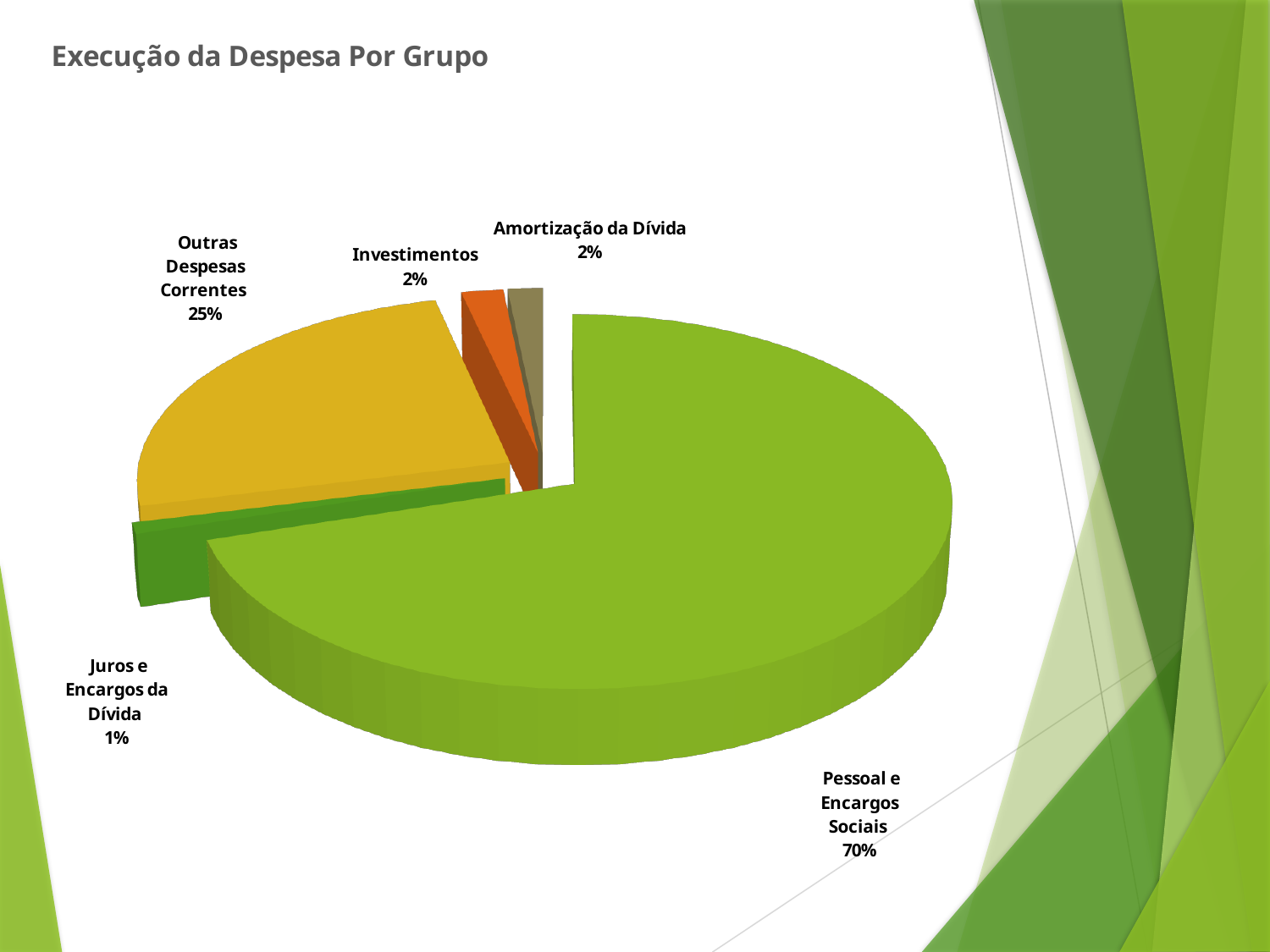
Which category has the largest slice of the pie? Pessoal e Encargos Sociais What is the value shown for Juros e Encargos da Dívida? 1% What is the title of the slide? Execução da Despesa Por Grupo What is the difference in percentage points between Pessoal e Encargos Sociais and Outras Despesas Correntes? 45 How many categories are shown in the pie chart? 5 What is the value shown for Investimentos? 2% Which category has the smallest slice of the pie? Juros e Encargos da Dívida What share of the pie does Pessoal e Encargos Sociais represent? 70% Which is larger, Outras Despesas Correntes or Investimentos? Outras Despesas Correntes What share of the pie does Outras Despesas Correntes represent? 25% What kind of chart is shown on the slide? Pie chart What is the value shown for Amortização da Dívida? 2%